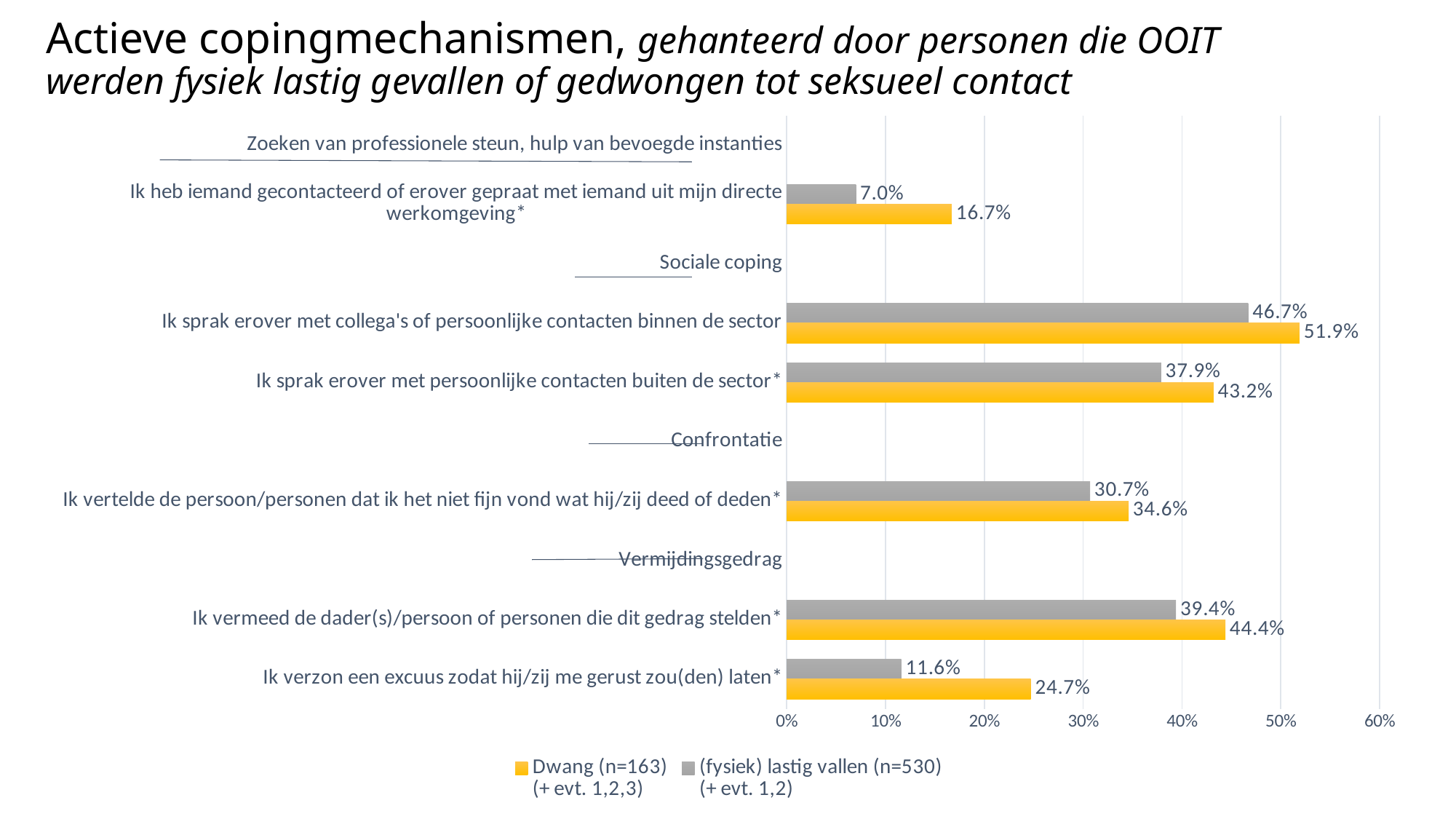
How many series does the legend list? 2 Which category has the lowest value for the '(fysiek) lastig vallen (n=530)' series? Ik heb iemand gecontacteerd of erover gepraat met iemand uit mijn directe werkomgeving What kind of chart is shown on the slide? bar chart What is the value for '(fysiek) lastig vallen (n=530)' for 'Ik heb iemand gecontacteerd of erover gepraat met iemand uit mijn directe werkomgeving'? 7.0% Which category has the highest value for the 'Dwang (n=163)' series? Ik sprak erover met collega's of persoonlijke contacten binnen de sector What is the value for '(fysiek) lastig vallen (n=530)' for 'Ik verzon een excuus zodat hij/zij me gerust zou(den) laten'? 11.6% What is the difference between the 'Dwang (n=163)' and '(fysiek) lastig vallen (n=530)' values for 'Ik verzon een excuus zodat hij/zij me gerust zou(den) laten'? 13.1% What is the value for 'Dwang (n=163)' for 'Ik sprak erover met collega's of persoonlijke contacten binnen de sector'? 51.9% Is the 'Dwang (n=163)' value for 'Ik sprak erover met persoonlijke contacten buiten de sector' greater or less than 40%? greater Which colour represents the 'Dwang (n=163)' series? yellow For 'Ik vertelde de persoon/personen dat ik het niet fijn vond wat hij/zij deed of deden', which series has the larger value? Dwang (n=163) What is the difference between the 'Dwang (n=163)' and '(fysiek) lastig vallen (n=530)' values for 'Ik vermeed de dader(s)/persoon of personen die dit gedrag stelden'? 5.0%